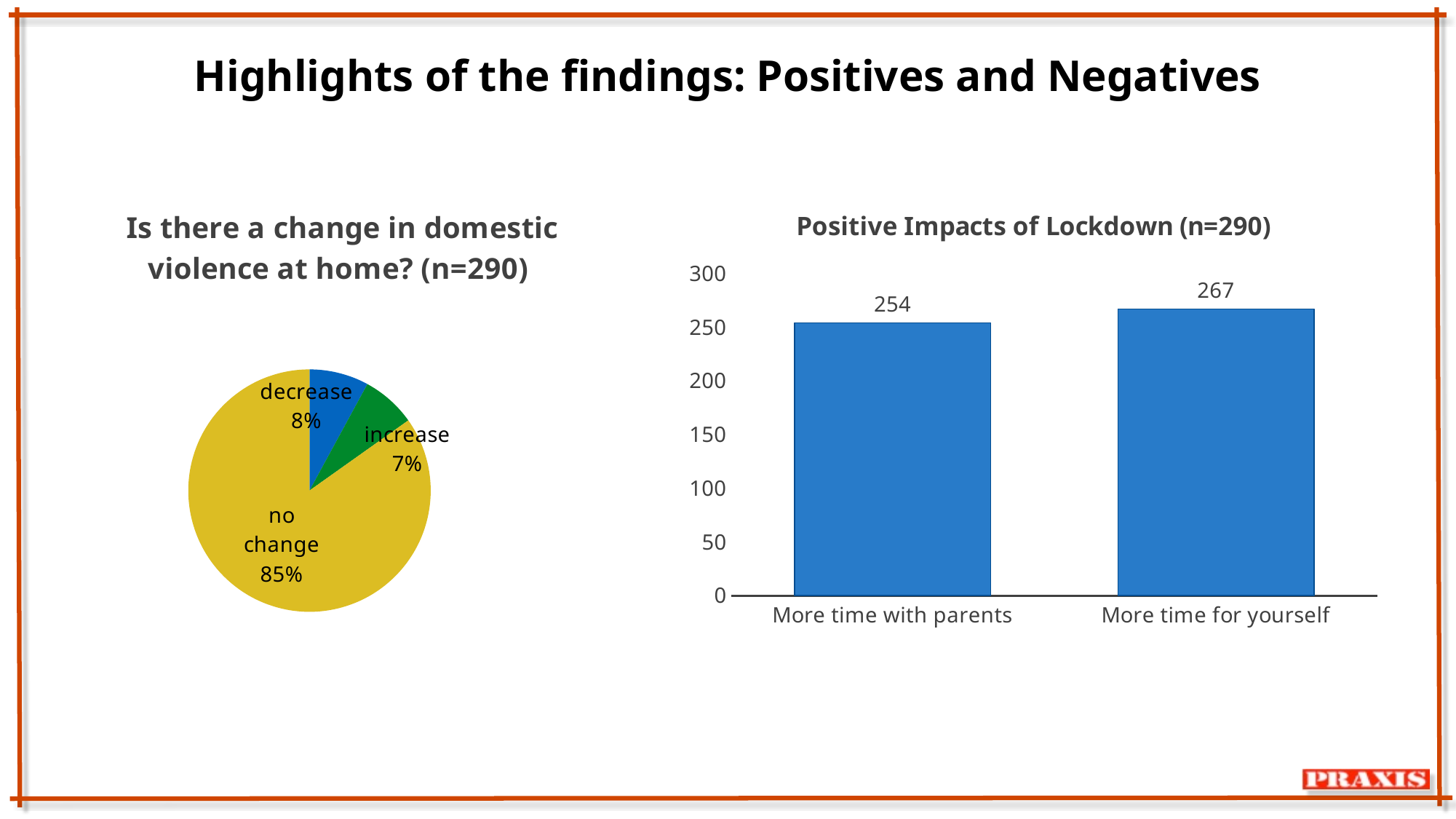
In the pie chart 'Is there a change in domestic violence at home? (n=290)', what share of respondents reported a decrease? 8% In the chart 'Positive Impacts of Lockdown (n=290)', what is the value for 'More time with parents'? 254 In the pie chart 'Is there a change in domestic violence at home? (n=290)', which slice is the largest? no change In the pie chart 'Is there a change in domestic violence at home? (n=290)', what share of respondents reported no change? 85% In the pie chart 'Is there a change in domestic violence at home? (n=290)', what share of respondents reported an increase? 7% What kind of chart is 'Positive Impacts of Lockdown (n=290)'? Bar chart In the pie chart 'Is there a change in domestic violence at home? (n=290)', how many slices are there? 3 In the pie chart 'Is there a change in domestic violence at home? (n=290)', which slice is the smallest? increase In the chart 'Positive Impacts of Lockdown (n=290)', which category has the higher value? More time for yourself In the chart 'Positive Impacts of Lockdown (n=290)', what is the value for 'More time for yourself'? 267 In the chart 'Positive Impacts of Lockdown (n=290)', what is the difference between 'More time for yourself' and 'More time with parents'? 13 In the pie chart 'Is there a change in domestic violence at home? (n=290)', what colour is the 'no change' slice? Yellow